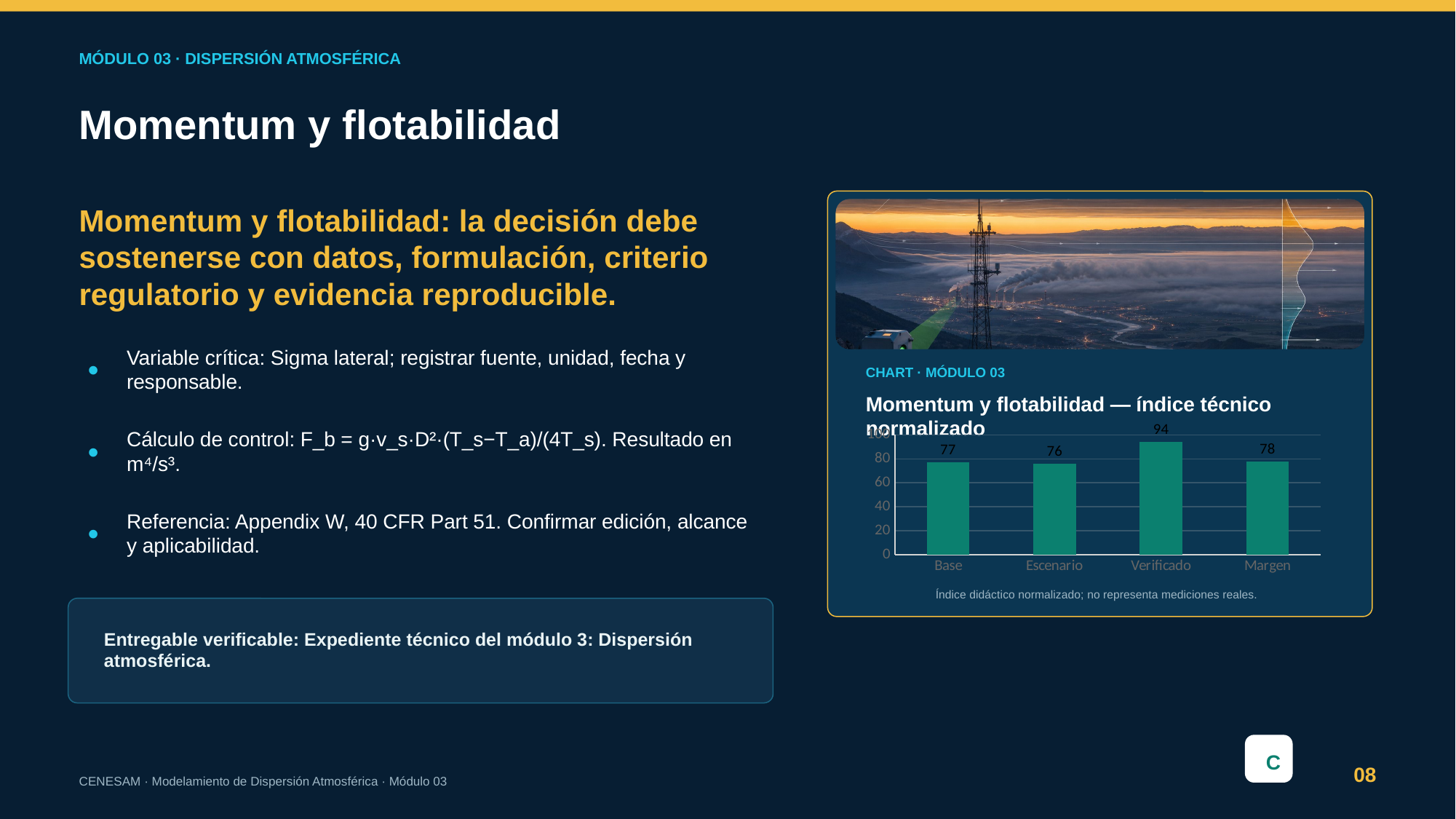
What is the value for Verificado? 94 What is the value for Escenario? 76 What is the difference between the values for Margen and Base? 1 What is the difference between the values for Verificado and Escenario? 18 What is the value for Base? 77 How many categories are shown on the x axis? 4 Is the value for Verificado greater or less than 80? greater Which is larger, the value for Verificado or the value for Base? Verificado Which category has the highest value? Verificado What is the value for Margen? 78 What is the title of the chart? Momentum y flotabilidad — índice técnico normalizado What kind of chart is shown? Bar chart